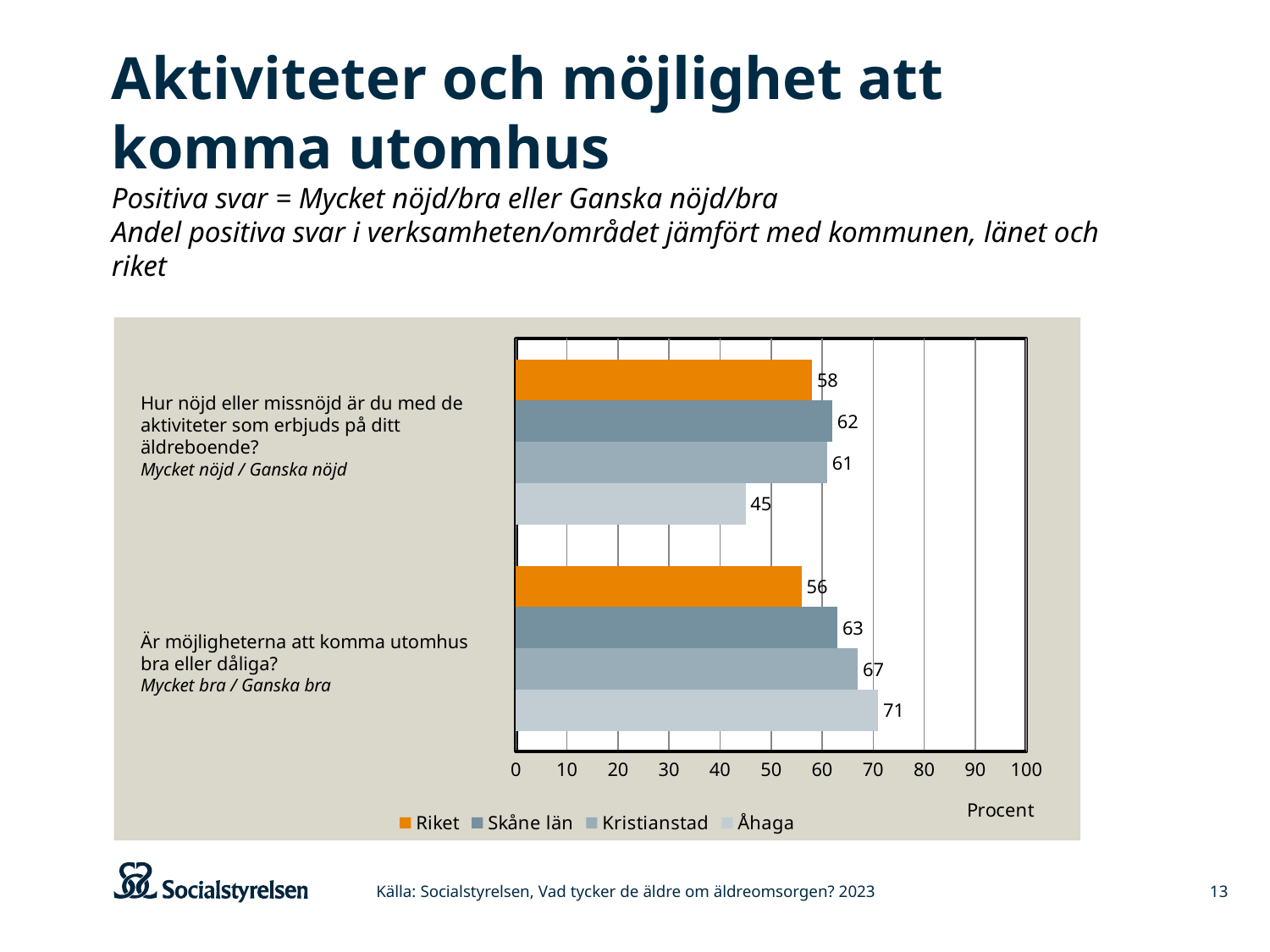
What is the difference between the Åhaga value and the Riket value on the question about opportunities to get outdoors? 15 What value is shown for Kristianstad on the question about opportunities to get outdoors? 67 How many series does the legend list? 4 What value is shown for Riket on the question about opportunities to get outdoors (Är möjligheterna att komma utomhus bra eller dåliga?)? 56 What is the difference between the Skåne län value and the Åhaga value on the question about activities offered at the care home? 17 Which series has the highest value on the question about opportunities to get outdoors? Åhaga What unit label is shown below the x axis of the chart? Procent What value is shown for Skåne län on the question about activities offered at the care home? 62 What value is shown for Åhaga on the question about activities offered at the care home (Hur nöjd eller missnöjd är du med de aktiviteter som erbjuds på ditt äldreboende?)? 45 Which series has the lowest value on the question about activities offered at the care home? Åhaga Which is larger on the question about activities offered at the care home: the value for Riket or the value for Kristianstad? Kristianstad What kind of chart is shown on the slide? Bar chart